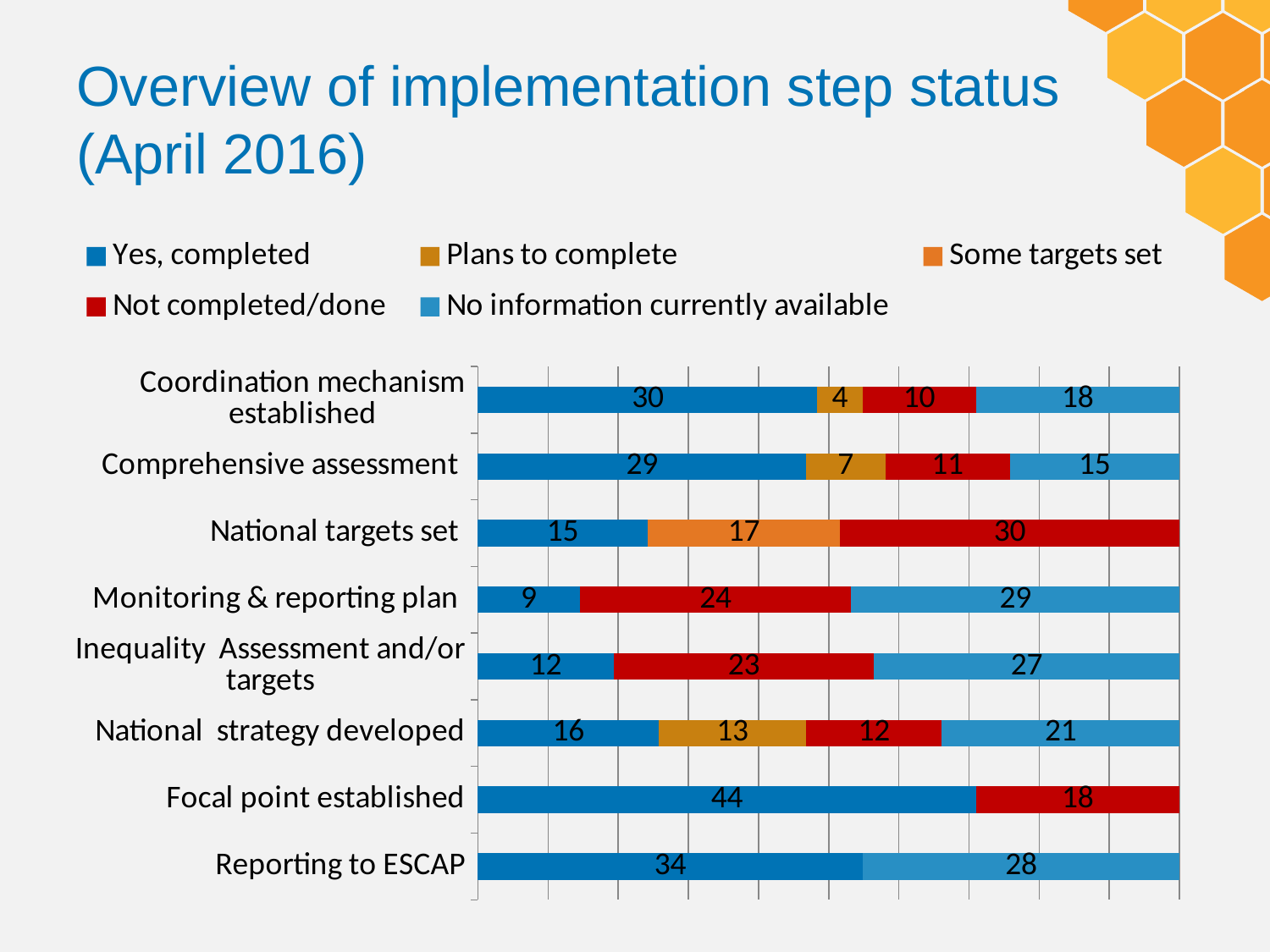
How many series does the legend list? 5 What is the difference between the 'Yes, completed' values for Reporting to ESCAP and Coordination mechanism established? 4 What is the 'No information currently available' value for Monitoring & reporting plan? 29 What is the total of the stacked bar for Comprehensive assessment? 62 Which implementation step has the highest 'Yes, completed' value? Focal point established Which is larger: the 'Not completed/done' value for Inequality Assessment and/or targets or for Monitoring & reporting plan? Monitoring & reporting plan What is the 'Not completed/done' value for National targets set? 30 What is the 'Plans to complete' value for National strategy developed? 13 What is the 'Yes, completed' value for Focal point established? 44 Which implementation step has the lowest 'Yes, completed' value? Monitoring & reporting plan What type of chart is shown on the slide? Stacked bar chart How many implementation steps (categories) are shown in the chart? 8